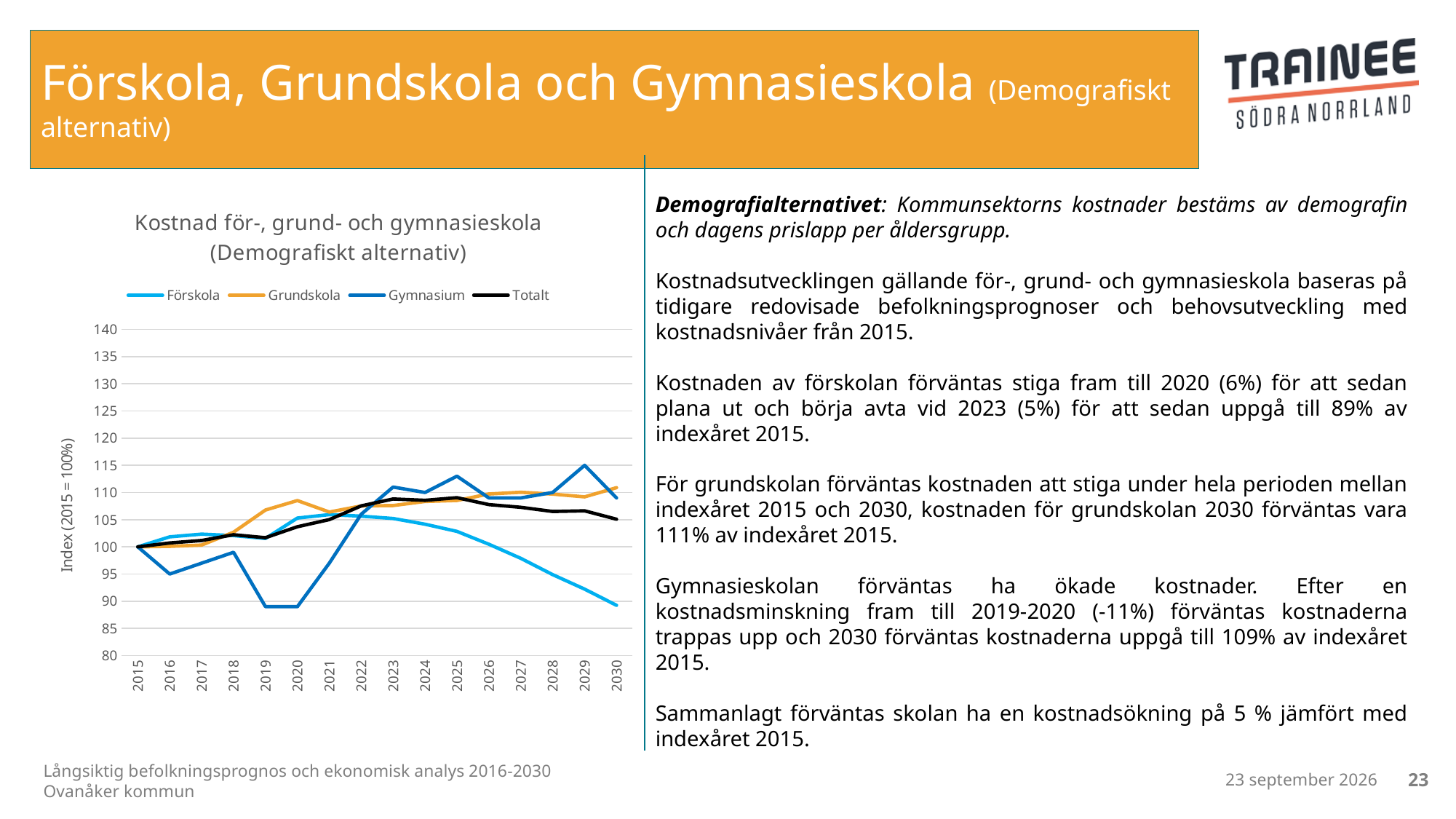
In 2030, which is larger: the value for Gymnasium or the value for Förskola? Gymnasium Does the Förskola line rise or fall between 2023 and 2030? fall Which series has the lowest value in 2030? Förskola Which series has the lowest value in 2019? Gymnasium Is the value for Grundskola in 2030 greater or less than 105? greater Is the value for Förskola in 2030 greater or less than 95? less What kind of chart is shown on the slide? line chart What is the index value for Totalt in 2015? 100 How many series does the chart legend list? 4 How many years are plotted along the x axis of the chart? 16 Which series has the highest value in 2029? Gymnasium Is the value for Gymnasium in 2019 greater or less than 95? less